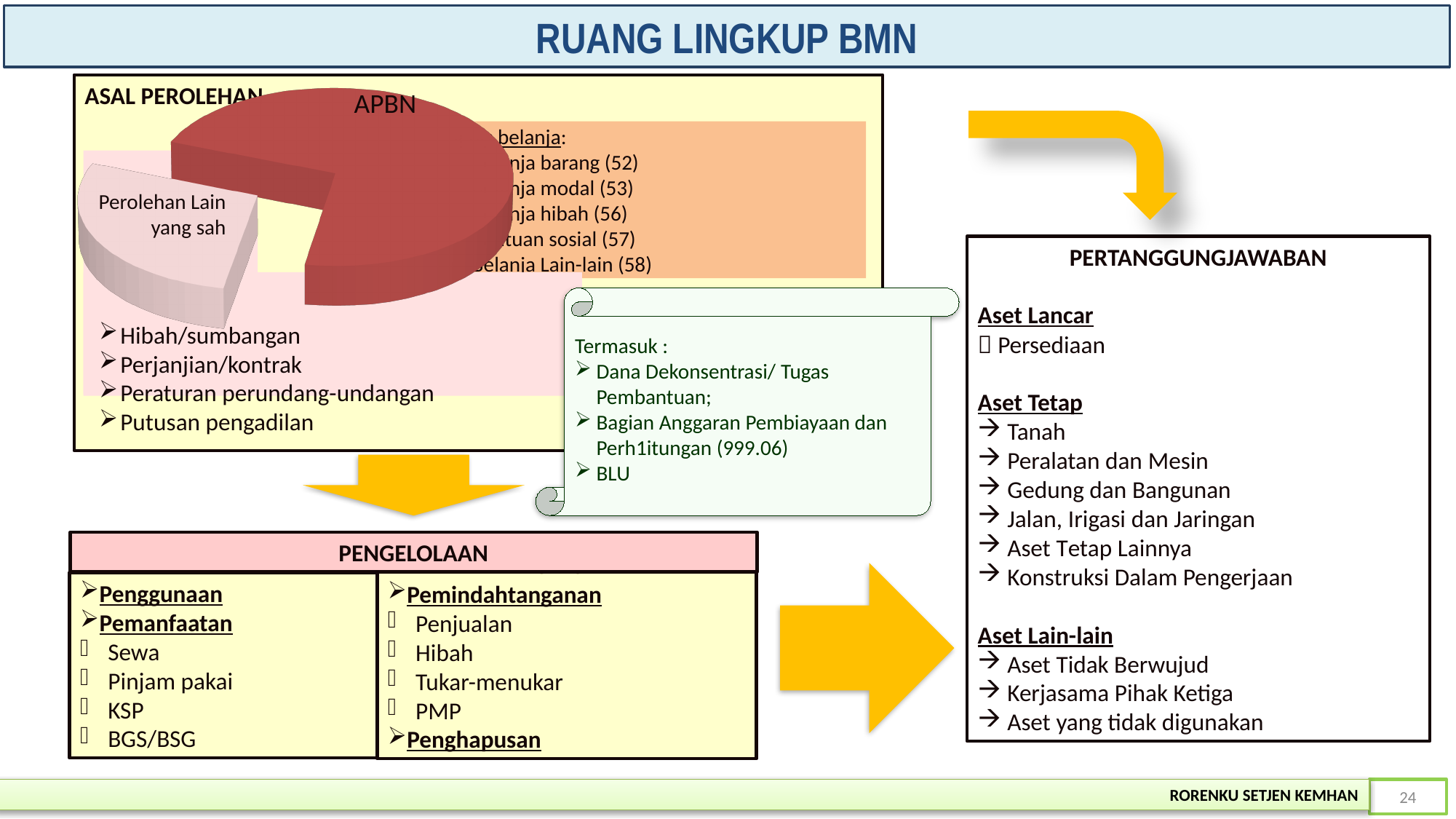
What colour is the APBN slice of the pie chart? Dark red What kind of chart is shown in the ASAL PEROLEHAN box? Pie chart Which slice of the pie chart is the smallest? Perolehan Lain yang sah Which slice of the pie chart is the largest? APBN Which slice is larger in the pie chart, APBN or Perolehan Lain yang sah? APBN How many slices does the pie chart have? 2 What are the labels of the two slices in the pie chart? APBN and Perolehan Lain yang sah